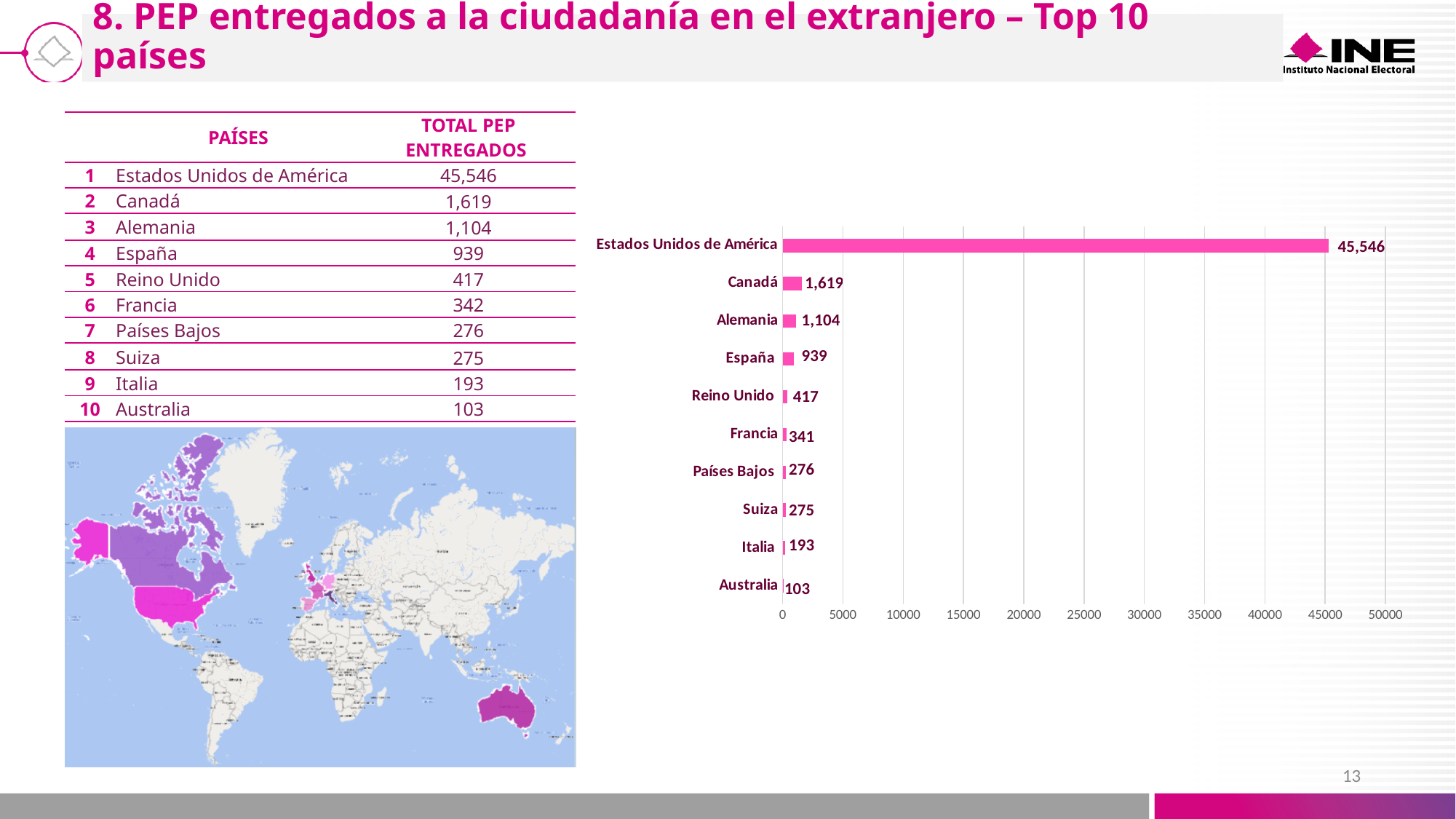
What is the value for Estados Unidos de América in the bar chart? 45,546 How many countries are plotted in the bar chart? 10 What is the value for Alemania in the bar chart? 1,104 What type of chart is shown on the slide? bar chart What is the difference between the values for Italia and Australia in the bar chart? 90 Which has a larger value in the bar chart, España or Reino Unido? España Is the value for Estados Unidos de América in the bar chart greater or less than 40000? greater What is the value for Canadá in the bar chart? 1,619 What is the difference between the values for Canadá and Alemania in the bar chart? 515 What is the value for Australia in the bar chart? 103 Which country has the lowest value in the bar chart? Australia Which country has the highest value in the bar chart? Estados Unidos de América